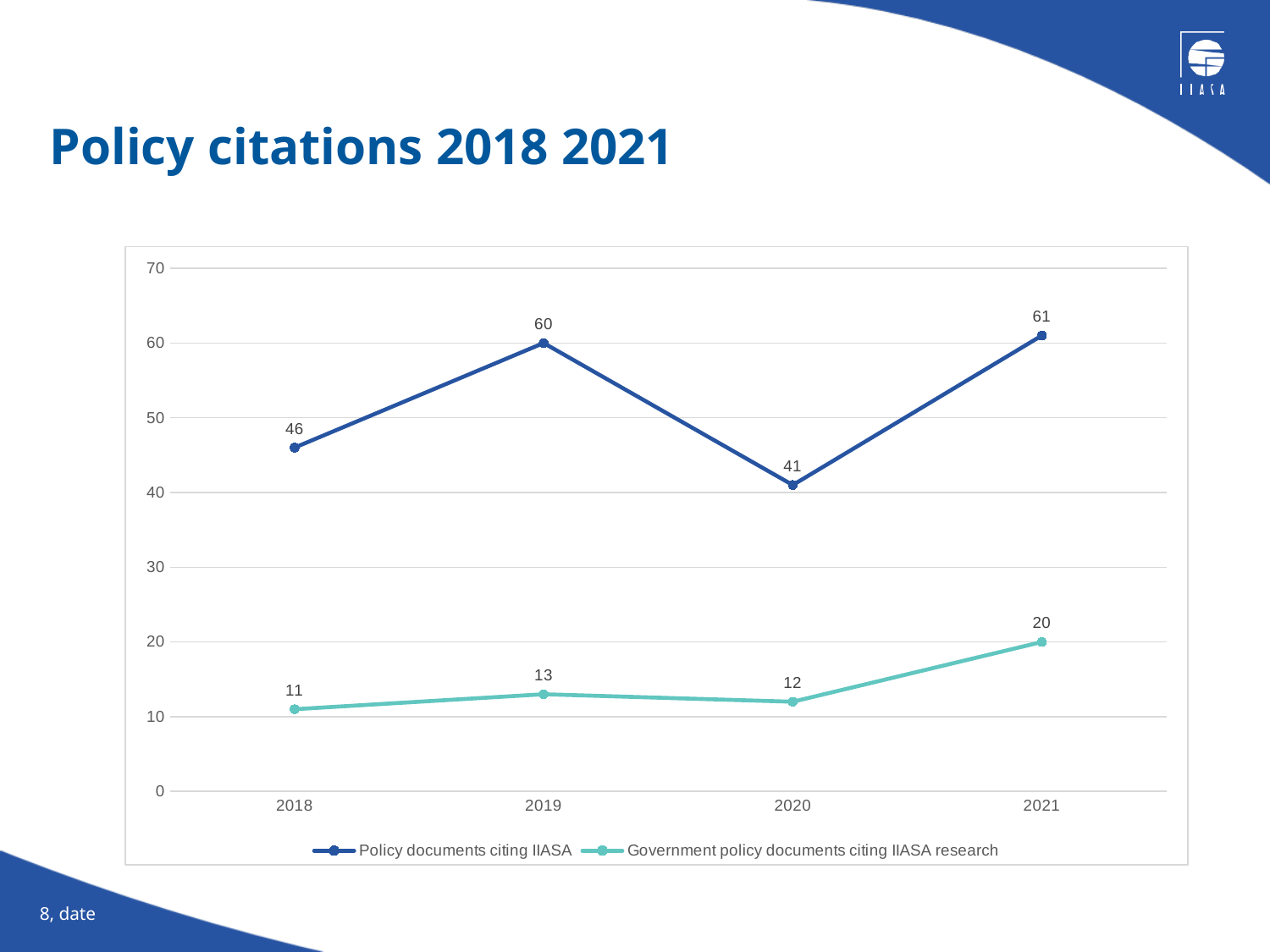
What is the value for Policy documents citing IIASA in 2019? 60 By how much did Policy documents citing IIASA change from 2019 to 2020? 19 What is the value for Government policy documents citing IIASA research in 2021? 20 What is the value for Policy documents citing IIASA in 2020? 41 Does the value for Government policy documents citing IIASA research rise or fall from 2020 to 2021? Rise In which year is the value for Policy documents citing IIASA highest? 2021 In which year is the value for Government policy documents citing IIASA research lowest? 2018 How many years are shown on the x axis? 4 What is the difference between Policy documents citing IIASA and Government policy documents citing IIASA research in 2018? 35 What kind of chart is shown on the slide? Line chart How many series does the legend list? 2 Which is larger: Policy documents citing IIASA in 2018 or in 2020? 2018